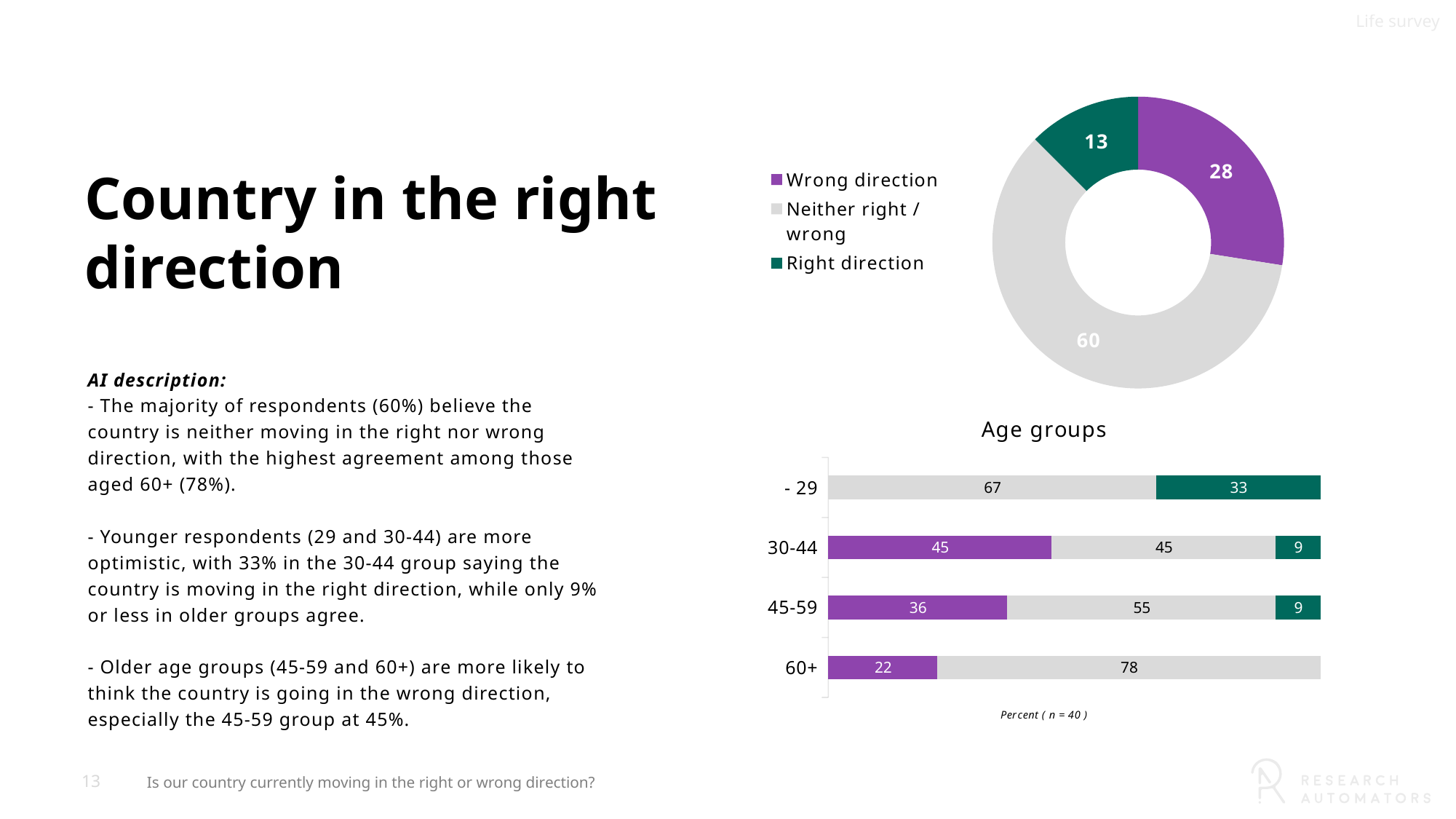
In the Age groups chart, which age group has the highest Wrong direction value? 30-44 In the Age groups chart, is the Wrong direction value larger for 45-59 or for 60+? 45-59 In the donut chart at the top, which segment is the largest? Neither right / wrong In the Age groups chart, what is the difference between the Neither right / wrong values for 60+ and 45-59? 23 In the Age groups chart, what is the Right direction value for the - 29 group? 33 In the Age groups chart, which age group has the highest Right direction value? - 29 In the donut chart at the top, what value is shown for Wrong direction? 28 In the donut chart at the top, which segment is the smallest? Right direction What type of chart is the Age groups chart? Stacked bar chart In the donut chart at the top, what is the difference between the Wrong direction and Right direction values? 15 In the Age groups chart, what is the Neither right / wrong value for the 60+ group? 78 How many age groups are shown in the Age groups chart? 4